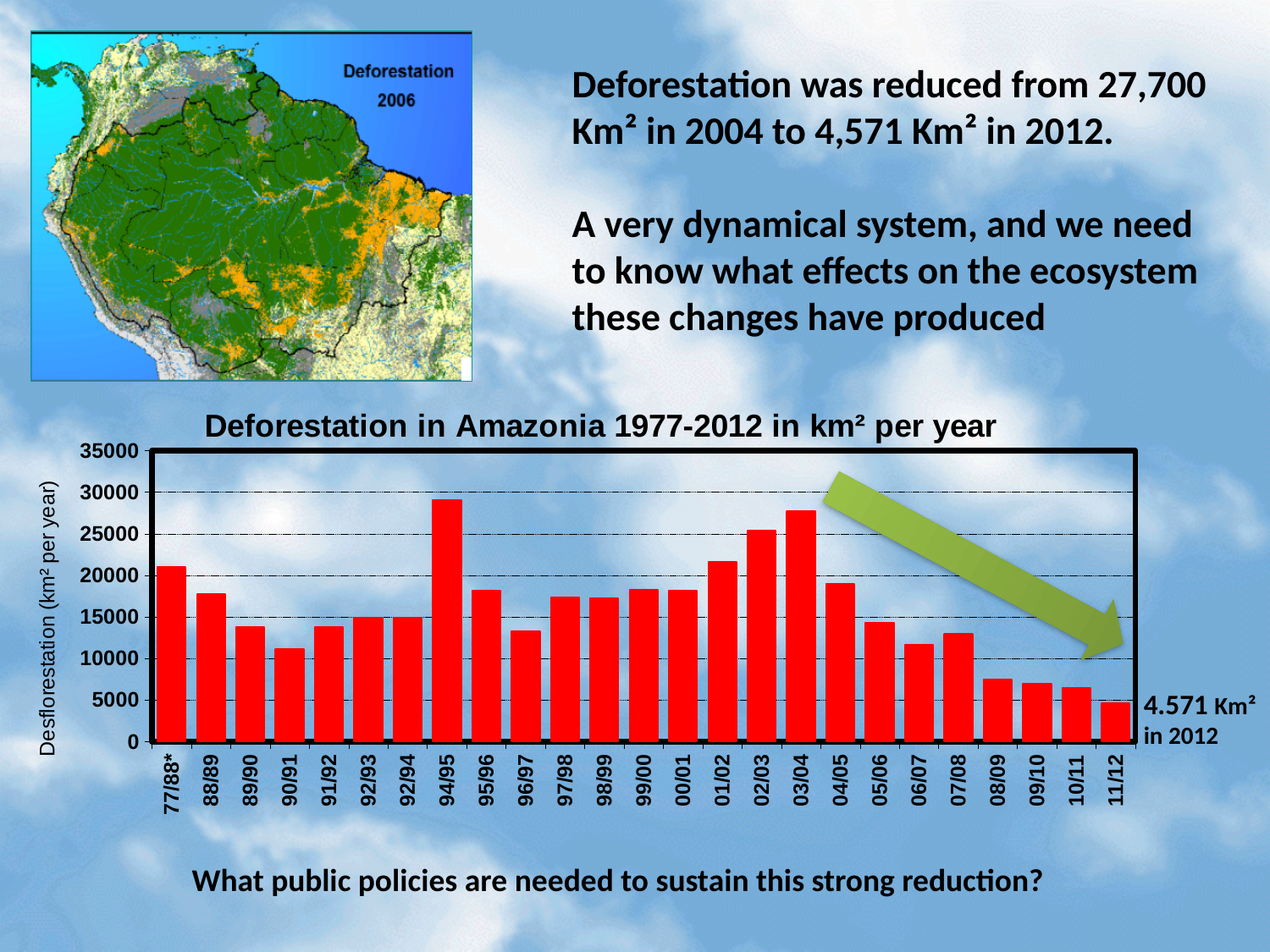
Is the value for 06/07 greater or less than 15000? less What kind of chart is shown on the slide? bar chart How many bars (periods) are plotted in the chart? 25 What deforestation value is labelled for 2012 (the 11/12 bar)? 4.571 Km² Which is larger, the value for 94/95 or the value for 03/04? 94/95 What colour are the bars in the chart? red Is the value for 08/09 greater or less than 10000? less Which period has the lowest deforestation value in the chart? 11/12 Is the value for 03/04 greater or less than 25000? greater Which period has the highest deforestation value in the chart? 94/95 Do the values rise or fall from 03/04 to 11/12? fall What is the title of the chart? Deforestation in Amazonia 1977-2012 in km² per year